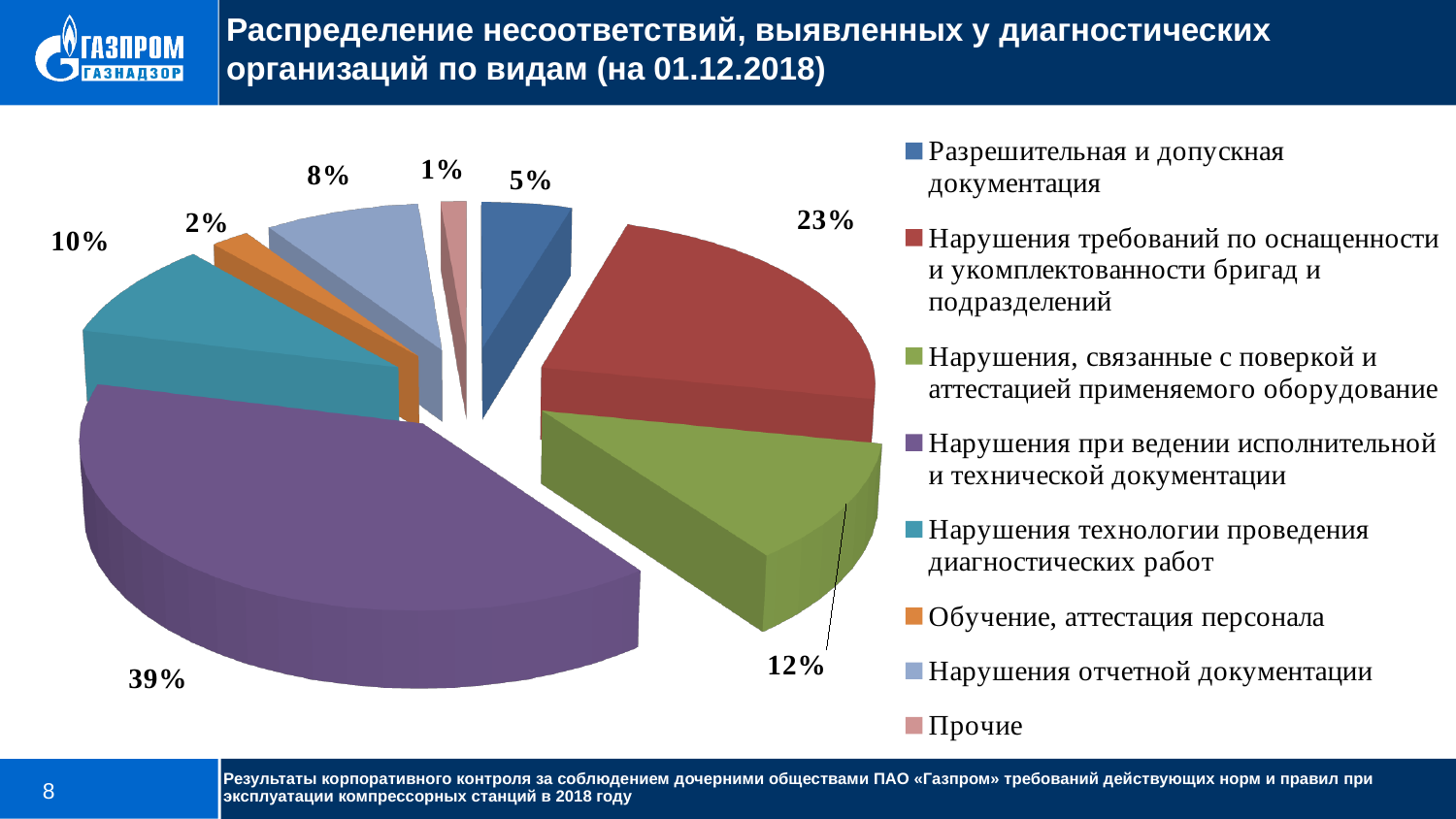
Какой тип диаграммы показан на слайде? Круговая диаграмма Какую долю занимает категория «Прочие»? 1% Какой вид несоответствий имеет наименьшую долю на диаграмме? Прочие Какую долю занимает категория «Обучение, аттестация персонала»? 2% На сколько процентных пунктов доля нарушений при ведении исполнительной и технической документации больше доли нарушений требований по оснащенности и укомплектованности бригад и подразделений? 16 Какую долю на круговой диаграмме занимают нарушения при ведении исполнительной и технической документации? 39% Сколько категорий (секторов) показано на диаграмме? 8 Какой вид несоответствий имеет наибольшую долю на диаграмме? Нарушения при ведении исполнительной и технической документации Что больше: доля нарушений отчетной документации или доля разрешительной и допускной документации? Нарушения отчетной документации